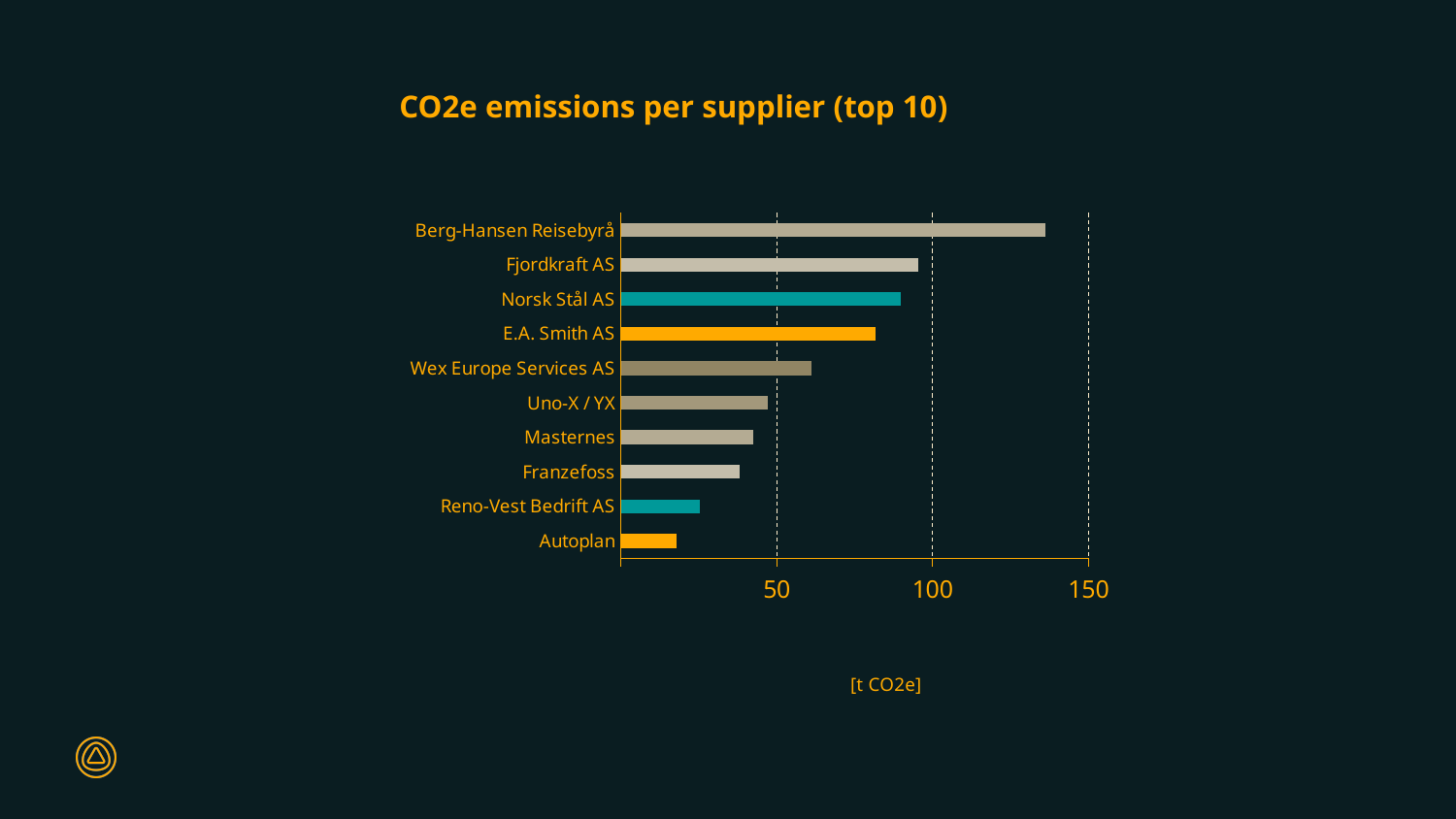
Which has higher CO2e emissions, Wex Europe Services AS or Uno-X / YX? Wex Europe Services AS Is the value for Norsk Stål AS greater or less than 100? less What unit is shown on the x axis of the chart? [t CO2e] Which supplier has the highest CO2e emissions? Berg-Hansen Reisebyrå Is the value for E.A. Smith AS greater or less than 50? greater What kind of chart is shown on the slide? bar chart Is the value for Autoplan greater or less than 50? less What is the title of the chart? CO2e emissions per supplier (top 10) How many suppliers are shown in the chart? 10 Which supplier has the lowest CO2e emissions? Autoplan